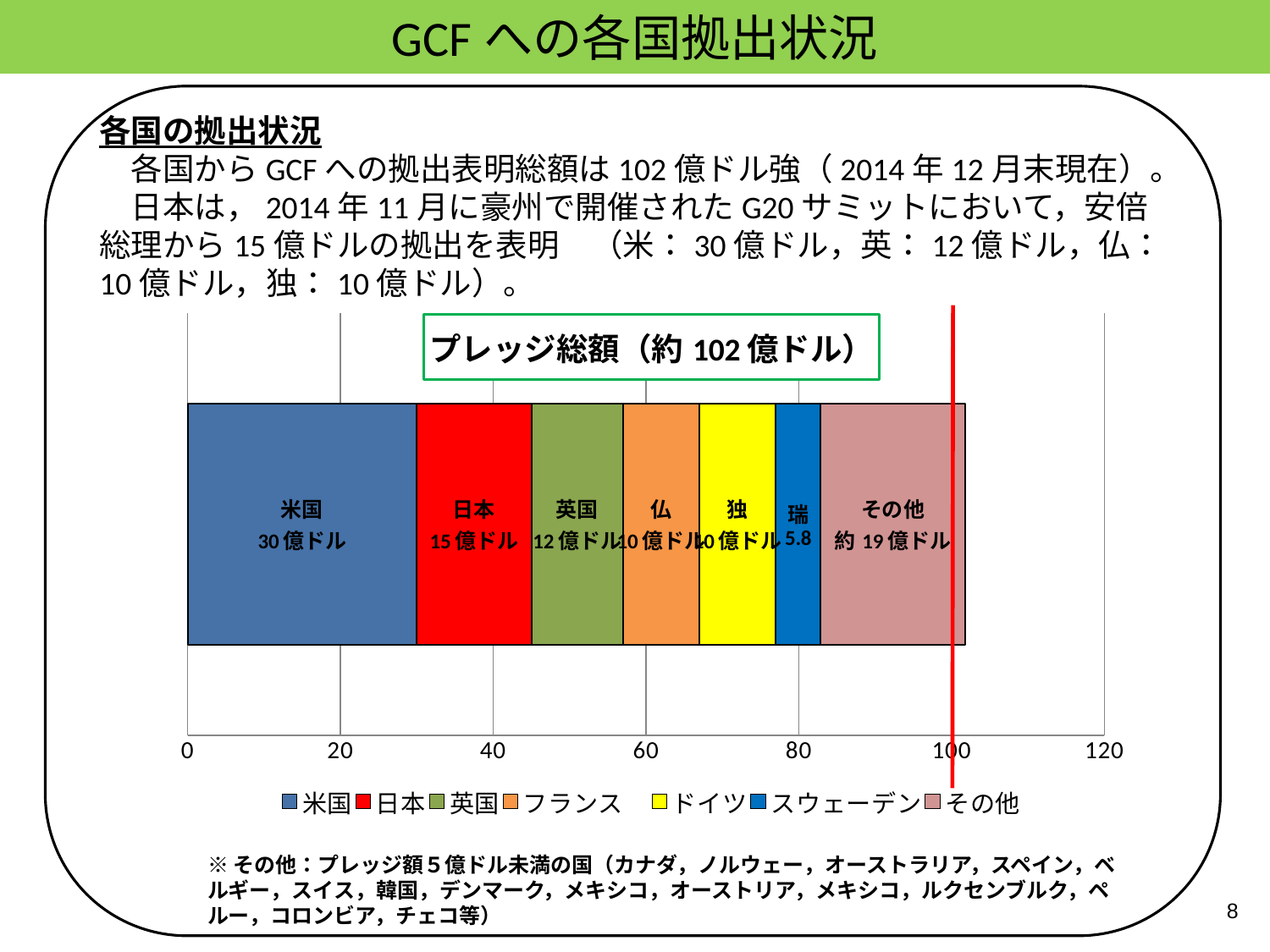
What is the pledged amount for 日本 (Japan) shown in the bar? 15億ドル Which segment in the bar is the smallest? 瑞 (スウェーデン) What colour represents 日本 in the chart? Red How many series does the legend list? 7 What amount is shown for その他 (Others) in the bar? 約19億ドル What total pledge amount does the chart state for the whole bar? 約102億ドル What type of chart is shown on the slide? Stacked bar chart Which is larger, the pledge of 日本 or the pledge of 英国? 日本 What is the pledged amount for 米国 (United States) shown in the bar? 30億ドル What value is shown for 瑞 (Sweden) in the bar? 5.8 How much larger is the 米国 pledge than the 日本 pledge? 15億ドル Which country has the largest pledge segment in the bar? 米国